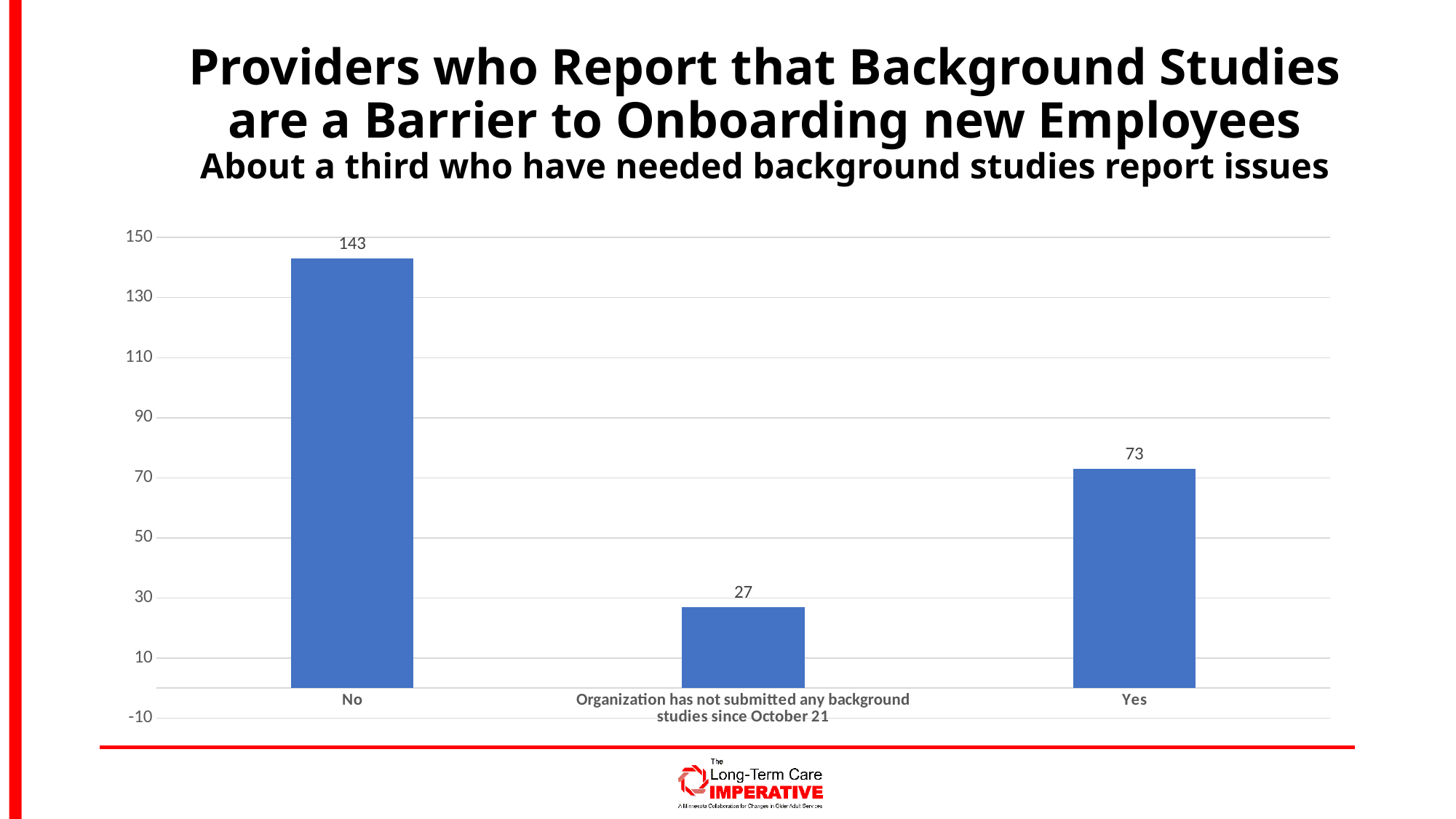
Is the value for "Yes" greater or less than 90? less What is the value for the "Yes" category? 73 What is the difference between the values for "Yes" and "Organization has not submitted any background studies since October 21"? 46 Which category has the highest value? No Which category has the lowest value? Organization has not submitted any background studies since October 21 What is the difference between the values for "No" and "Yes"? 70 What is the subtitle shown below the chart's main title? About a third who have needed background studies report issues What is the value for "Organization has not submitted any background studies since October 21"? 27 What kind of chart is shown on the slide? Bar chart How many categories are shown on the chart? 3 What is the value for the "No" category? 143 Which is larger, the value for "Yes" or the value for "Organization has not submitted any background studies since October 21"? Yes